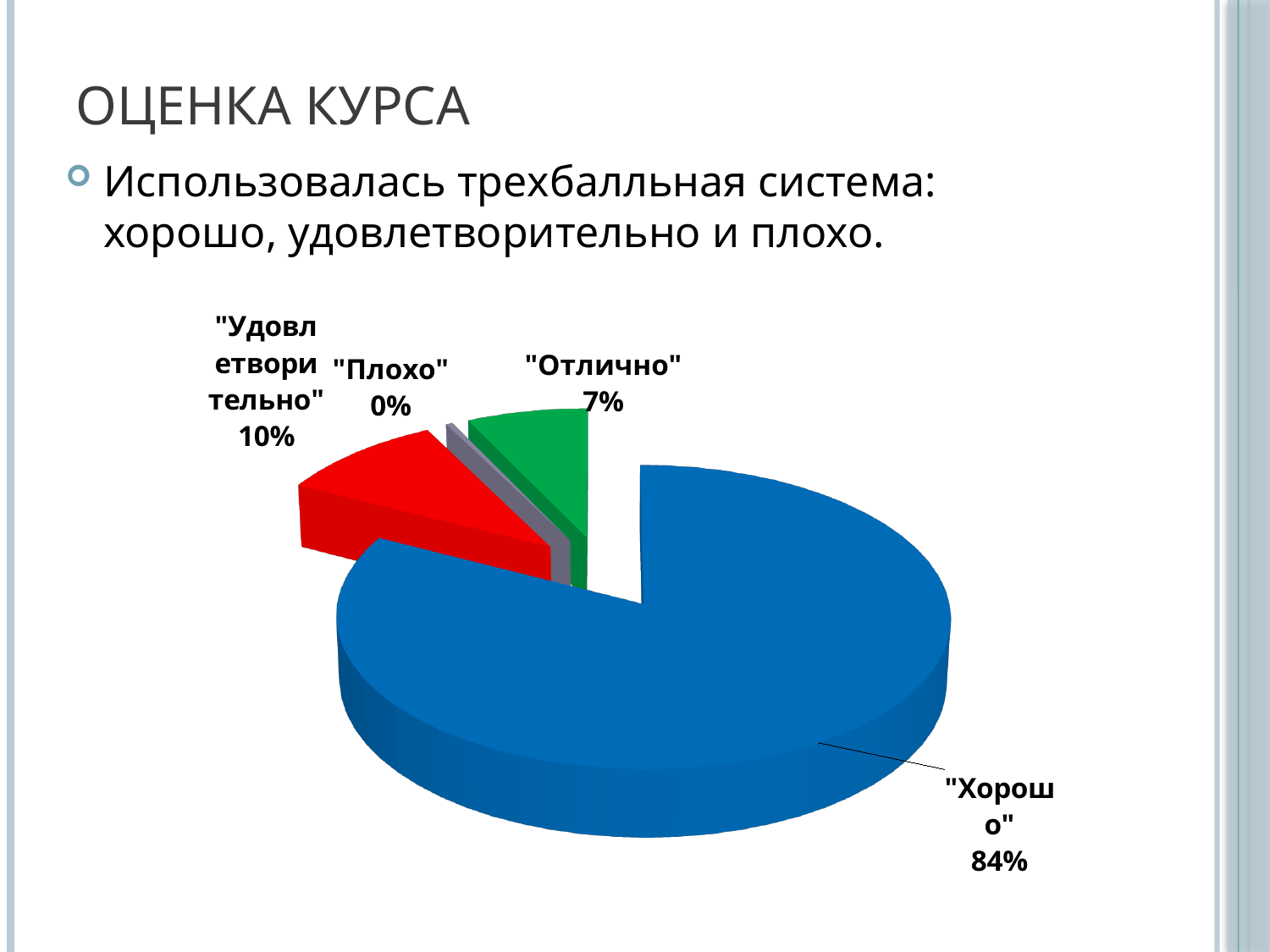
What percentage of the pie is labelled "Хорошо"? 84% What colour is the "Хорошо" slice of the pie chart? Blue Which slice is larger, "Удовлетворительно" or "Отлично"? "Удовлетворительно" Which slice of the pie chart is the largest? "Хорошо" What percentage of the pie is labelled "Удовлетворительно"? 10% How many slices (categories) does the pie chart have? 4 What percentage of the pie is labelled "Плохо"? 0% What is the difference in percentage points between the "Хорошо" slice and the "Удовлетворительно" slice? 74 Which slice of the pie chart is the smallest? "Плохо" What kind of chart is shown on the slide? Pie chart What percentage of the pie is labelled "Отлично"? 7% What colour is the "Отлично" slice of the pie chart? Green